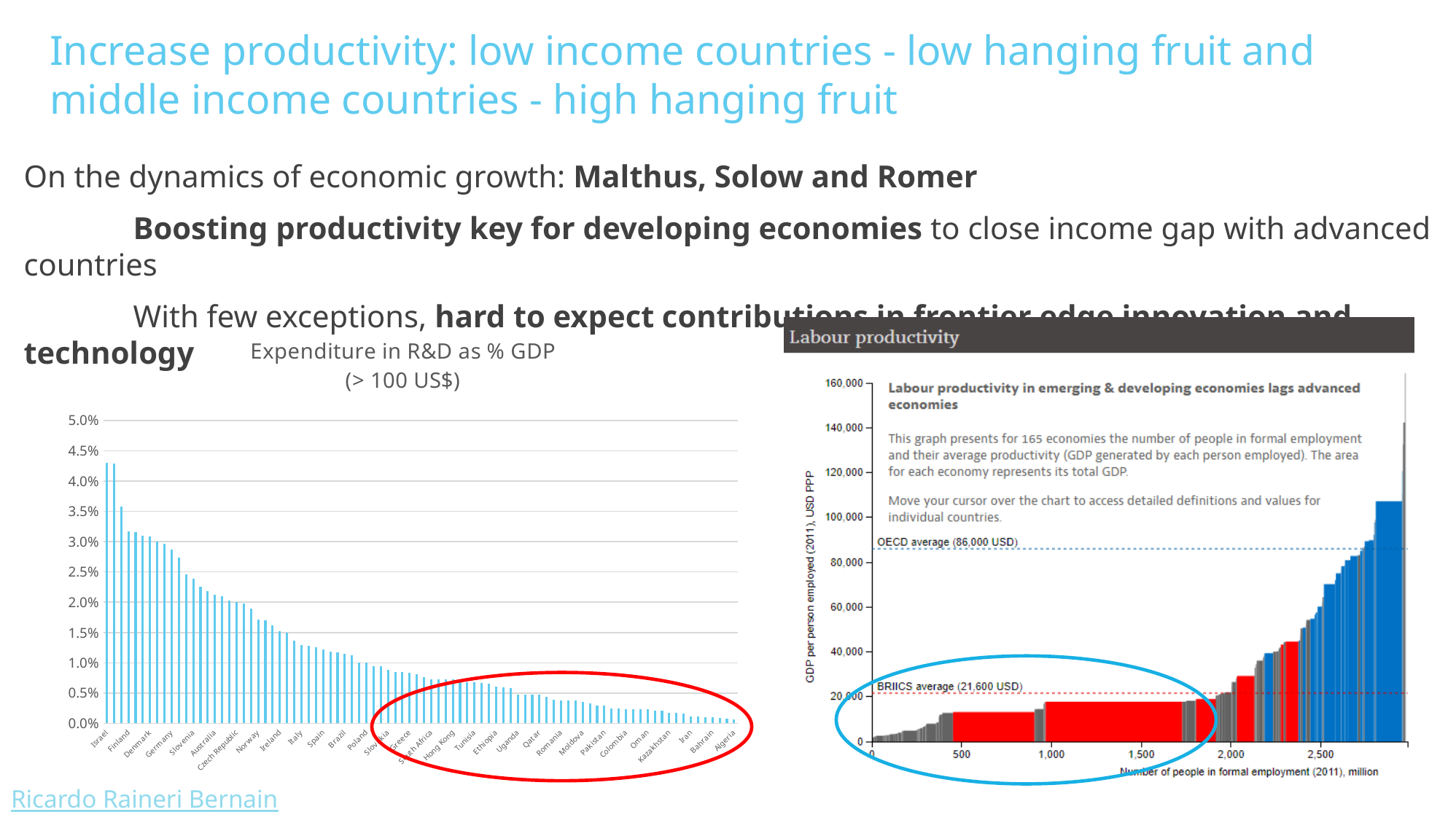
In the left chart 'Expenditure in R&D as % GDP', which country has the highest value? Israel In the left chart 'Expenditure in R&D as % GDP', is the value for Spain greater or less than 1.5%? less In the left chart 'Expenditure in R&D as % GDP', is the value for Finland greater or less than 3.0%? greater In the right chart 'Labour productivity', what is the BRIICS average GDP per person employed shown on the chart? 21,600 USD In the left chart 'Expenditure in R&D as % GDP', which country has the larger value, Israel or Finland? Israel In the right chart 'Labour productivity', what is the OECD average GDP per person employed shown on the chart? 86,000 USD In the left chart 'Expenditure in R&D as % GDP', which country has the lowest value? Algeria What type of chart is the left chart titled 'Expenditure in R&D as % GDP'? bar chart In the right chart 'Labour productivity', what is the difference between the OECD average and the BRIICS average? 64,400 USD In the left chart 'Expenditure in R&D as % GDP', do the values rise or fall moving from left to right along the x axis? fall In the left chart 'Expenditure in R&D as % GDP', is the value for Israel greater or less than 4.0%? greater